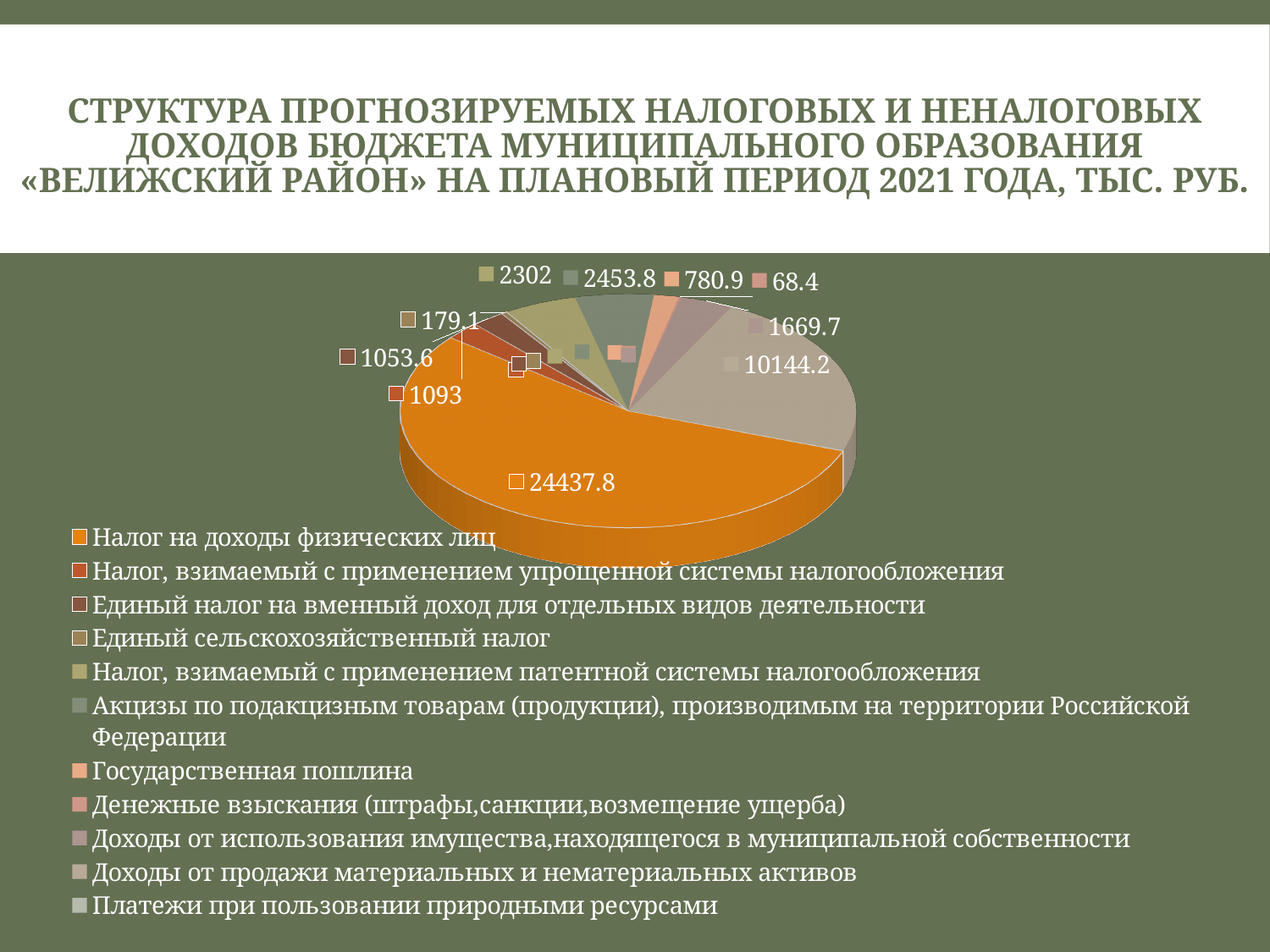
How many entries does the legend of the pie chart list? 11 What is the value shown for Налог на доходы физических лиц? 24437.8 Which is larger: the slice for Налог на доходы физических лиц or the slice for Доходы от продажи материальных и нематериальных активов? Налог на доходы физических лиц What is the value shown for Доходы от использования имущества, находящегося в муниципальной собственности? 1669.7 What kind of chart is shown on the slide? pie chart What is the smallest value labelled on the pie chart? 68.4 For which planning year does the slide title say the forecast revenues are shown? 2021 In what units are the values on the chart expressed, according to the slide title? тыс. руб. What is the difference between the value for Налог на доходы физических лиц (24437.8) and the value for Доходы от продажи материальных и нематериальных активов (10144.2)? 14293.6 What is the value shown for Доходы от продажи материальных и нематериальных активов? 10144.2 What is the value shown for Акцизы по подакцизным товарам (продукции), производимым на территории Российской Федерации? 2453.8 Which category has the largest slice of the pie chart? Налог на доходы физических лиц